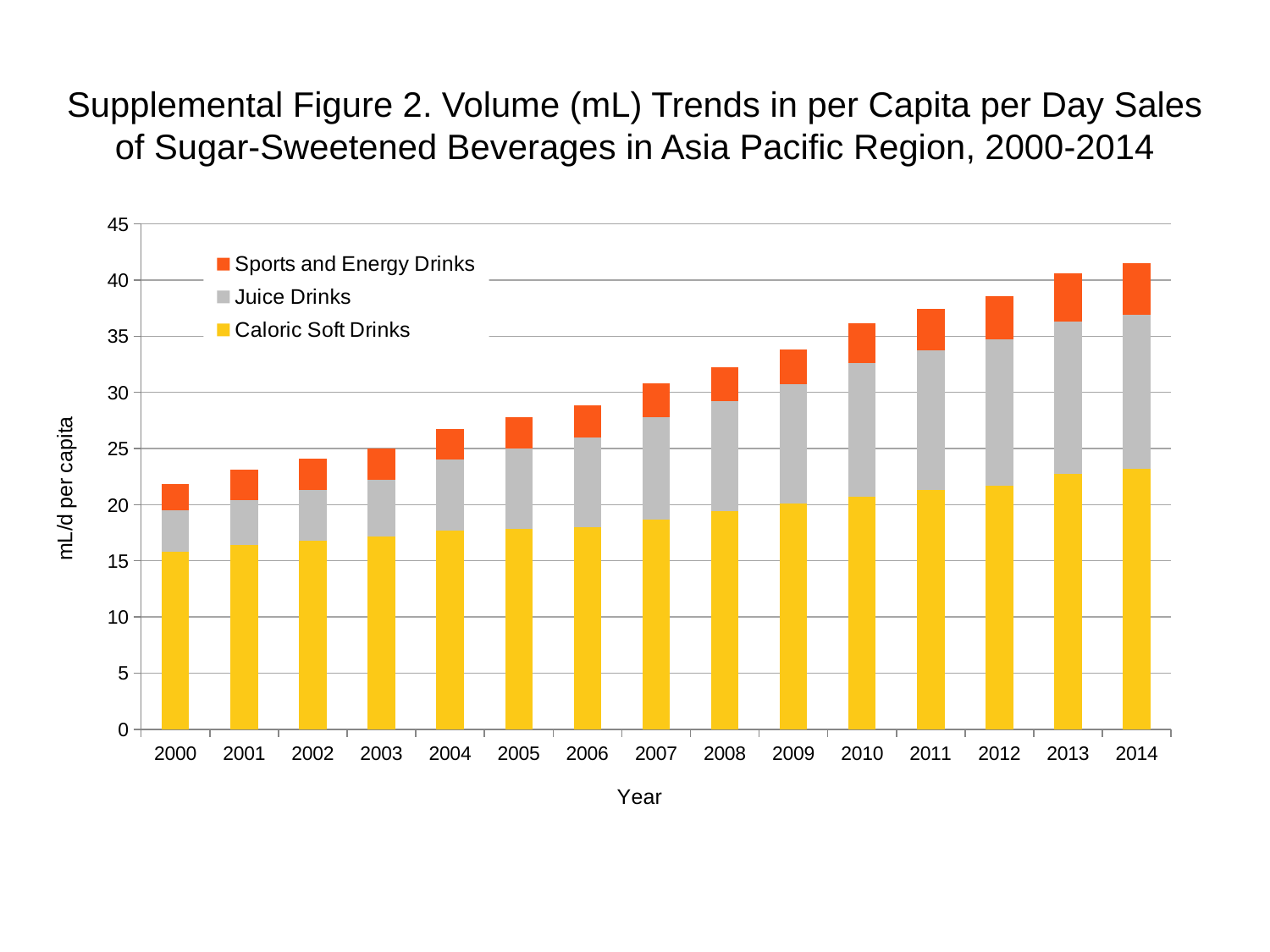
Do the total bar heights rise or fall from 2000 to 2014? Rise Is the total stacked value for 2005 greater or less than 30? less Which year has the lowest total stacked bar? 2000 Is the total stacked value for 2000 greater or less than 25? less Which year has the highest total stacked bar? 2014 What kind of chart is shown on the slide? Stacked bar chart Is the Caloric Soft Drinks value for 2000 greater or less than 20? less How many years are shown along the x axis? 15 What is the label on the y axis? mL/d per capita How many series does the legend list? 3